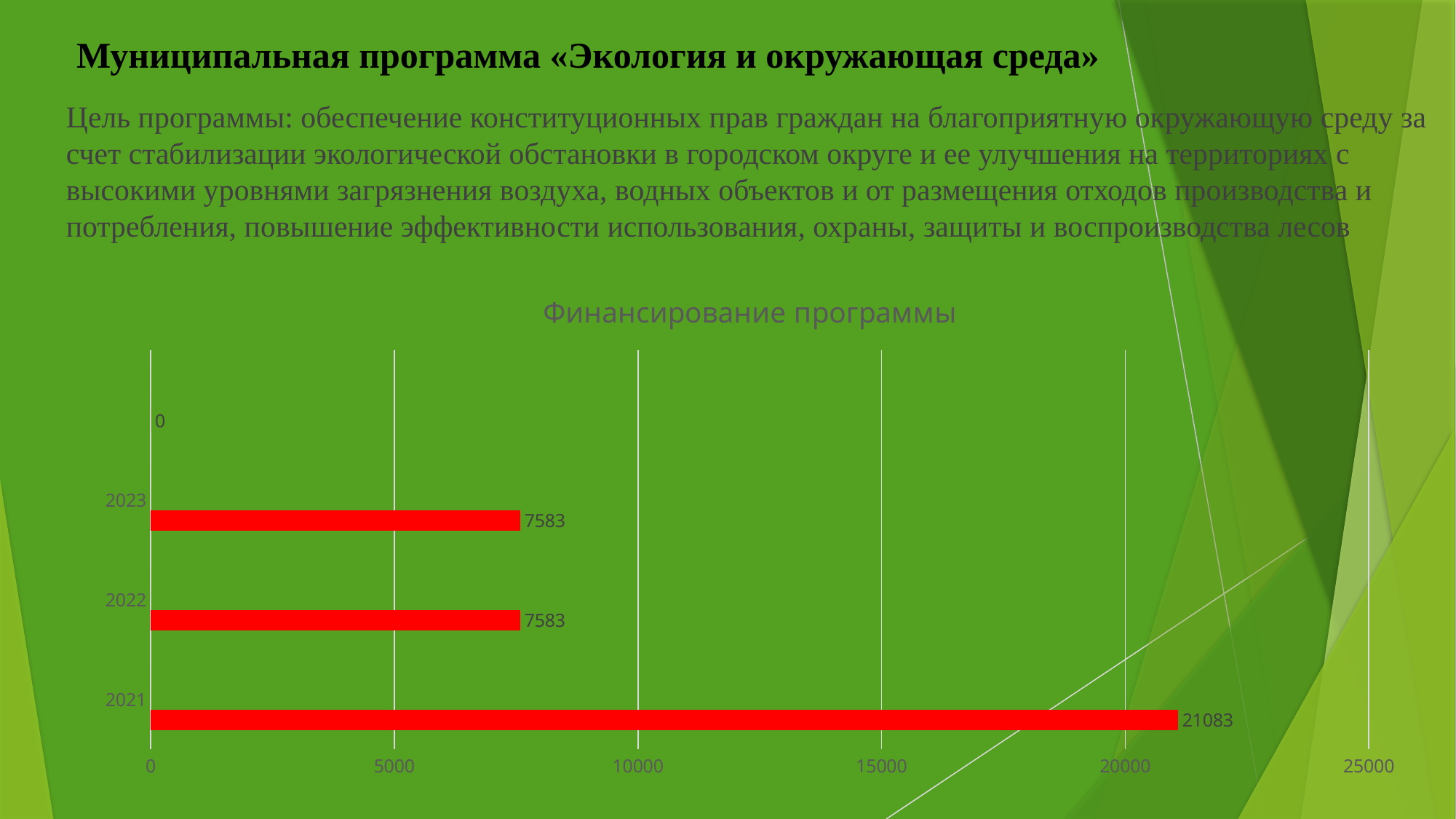
What is the value for 2023 in the chart? 7583 What is the title of the chart? Финансирование программы What kind of chart is shown on the slide? bar chart What is the value for 2021 in the chart? 21083 Is the value for 2023 greater or less than 10000? less Is the value for 2021 greater or less than 20000? greater What is the difference between the values for 2021 and 2022? 13500 Which is larger, the value for 2021 or the value for 2023? 2021 How many years are labeled on the vertical axis of the chart? 3 What is the value for 2022 in the chart? 7583 What colour are the bars in the chart? red Which year has the highest value in the chart? 2021